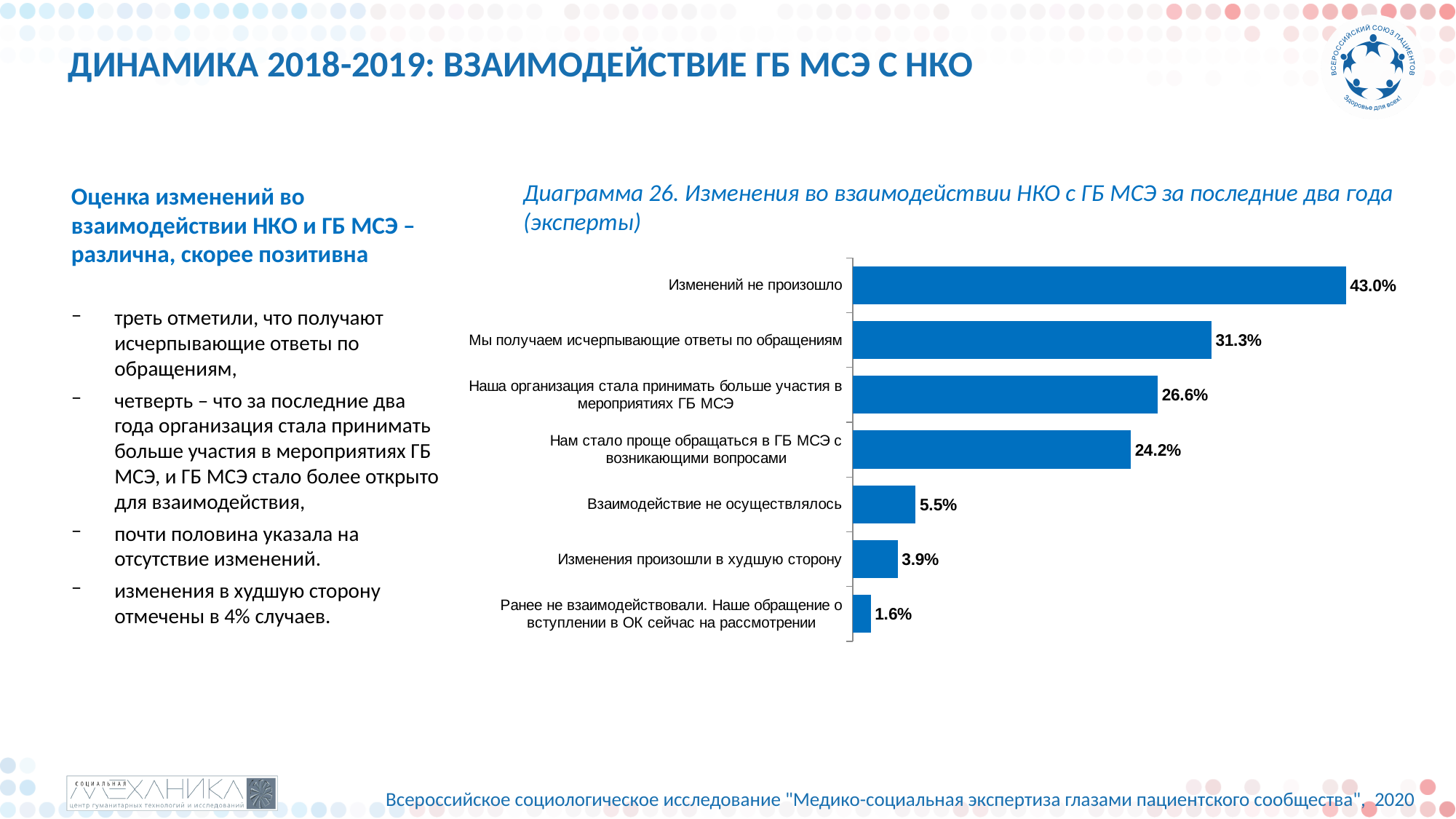
What kind of chart is shown on the slide? Bar chart What value is shown for "Мы получаем исчерпывающие ответы по обращениям"? 31.3% What value is shown for "Изменения произошли в худшую сторону"? 3.9% Which is larger: the value for "Взаимодействие не осуществлялось" or for "Изменения произошли в худшую сторону"? Взаимодействие не осуществлялось What is the difference between the values for "Наша организация стала принимать больше участия в мероприятиях ГБ МСЭ" and "Нам стало проще обращаться в ГБ МСЭ с возникающими вопросами"? 2.4% Which category has the lowest value? Ранее не взаимодействовали. Наше обращение о вступлении в ОК сейчас на рассмотрении What value is shown for "Взаимодействие не осуществлялось"? 5.5% Which category has the highest value? Изменений не произошло What value is shown for "Изменений не произошло"? 43.0% What is the difference between the values for "Изменений не произошло" and "Мы получаем исчерпывающие ответы по обращениям"? 11.7% What is the title of the chart? Диаграмма 26. Изменения во взаимодействии НКО с ГБ МСЭ за последние два года (эксперты) How many categories are shown in the chart? 7